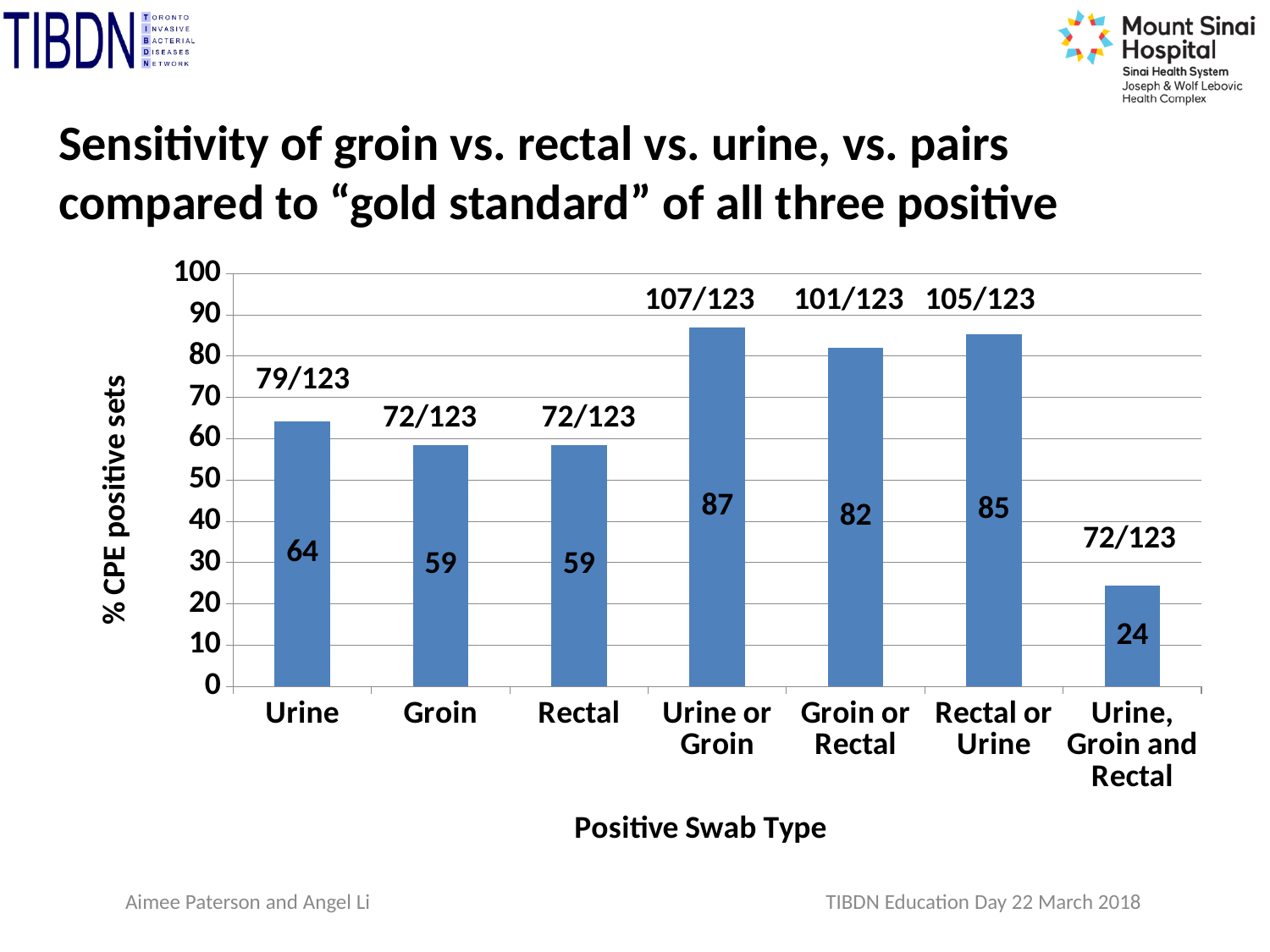
What is the % CPE positive sets value for Rectal or Urine? 85 What is the label of the y axis? % CPE positive sets How many positive swab type categories are shown on the x axis? 7 What kind of chart is shown on the slide? Bar chart Which positive swab type has the highest % CPE positive sets? Urine or Groin Which has a higher % CPE positive sets, Urine or Groin? Urine What fraction is printed above the Urine or Groin bar? 107/123 What is the % CPE positive sets value for Urine, Groin and Rectal? 24 Which positive swab type has the lowest % CPE positive sets? Urine, Groin and Rectal What fraction is printed above the Groin or Rectal bar? 101/123 What is the % CPE positive sets value for Urine? 64 What is the difference in % CPE positive sets between Urine or Groin and Groin or Rectal? 5